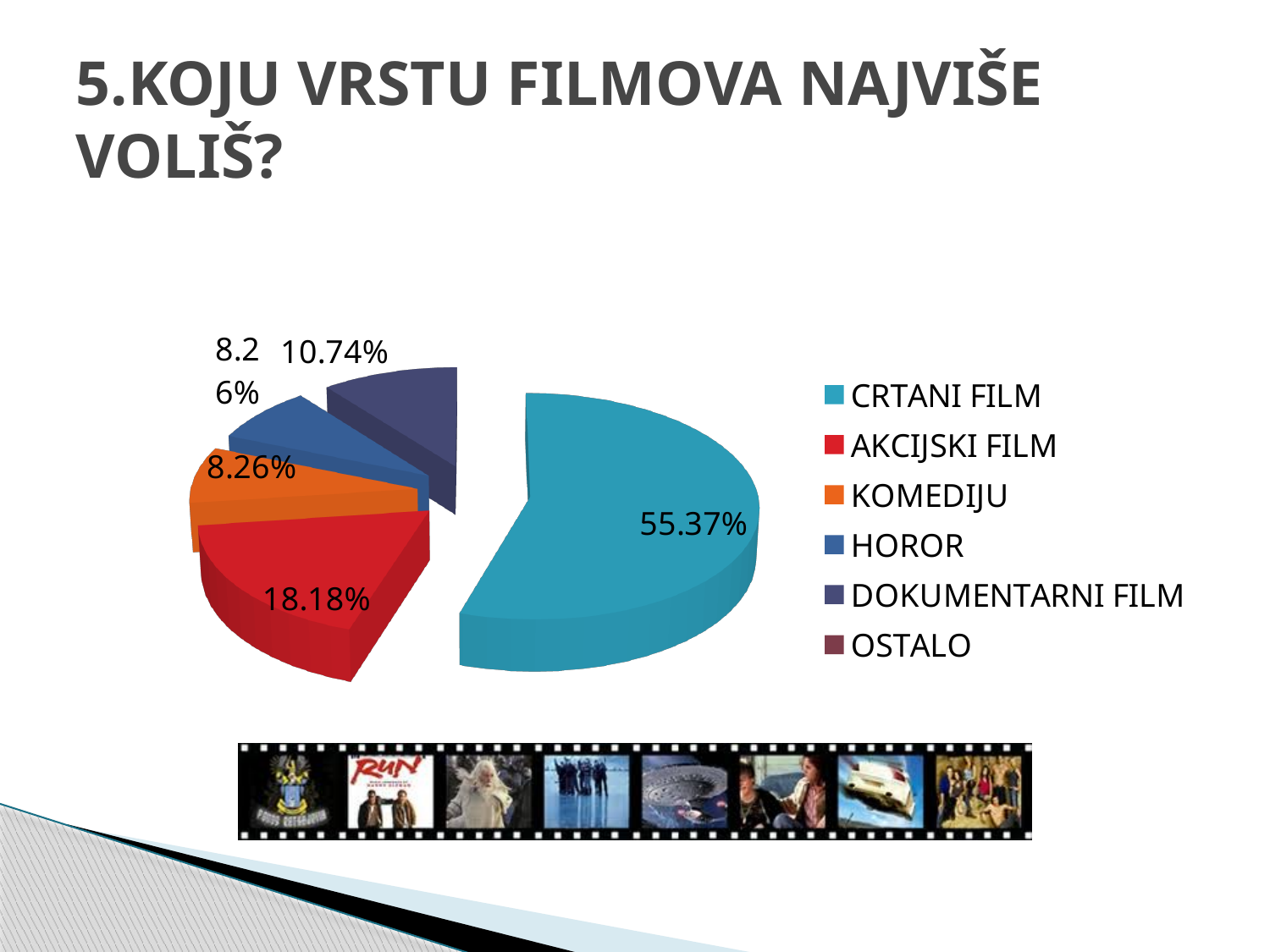
What percentage of the pie chart is CRTANI FILM? 55.37% What kind of chart is shown on the slide? Pie chart What percentage of the pie chart is DOKUMENTARNI FILM? 10.74% Which legend entry is listed last in the chart legend? OSTALO What percentage of the pie chart is AKCIJSKI FILM? 18.18% What percentage of the pie chart is KOMEDIJU? 8.26% Which slice is larger, AKCIJSKI FILM or DOKUMENTARNI FILM? AKCIJSKI FILM Which slice is larger, KOMEDIJU or DOKUMENTARNI FILM? DOKUMENTARNI FILM What is the difference in percentage points between DOKUMENTARNI FILM and KOMEDIJU? 2.48 Which film type has the largest slice of the pie chart? CRTANI FILM What is the difference in percentage points between CRTANI FILM and AKCIJSKI FILM? 37.19 How many entries does the chart legend list? 6